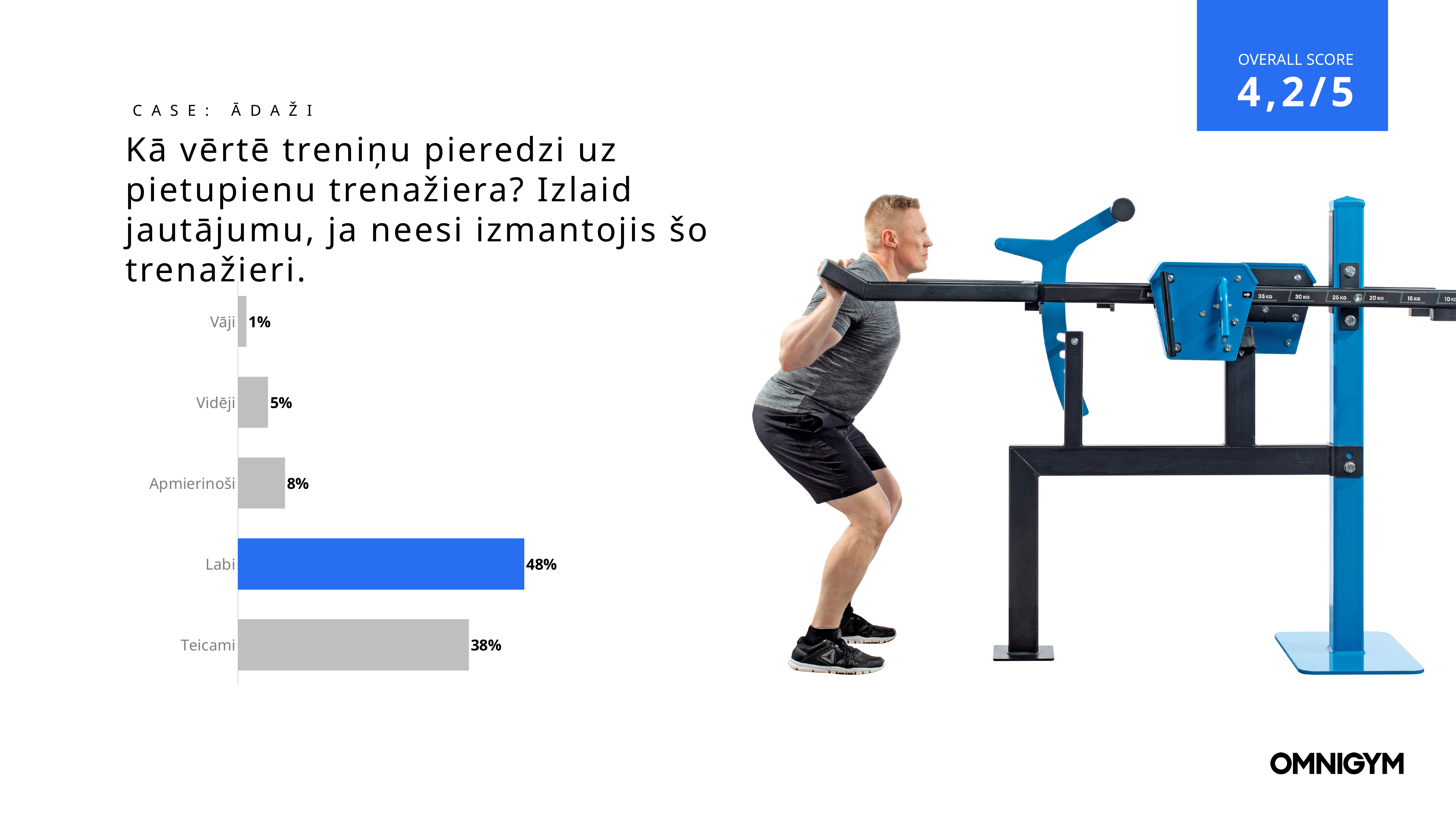
What is the difference between the values for Labi and Teicami? 10% What is the value for Labi? 48% Which category has the highest value? Labi What is the value for Teicami? 38% Which bar is highlighted in blue rather than grey? Labi What is the value for Vāji? 1% What is the value for Apmierinoši? 8% Which is larger, the value for Apmierinoši or the value for Vidēji? Apmierinoši What is the value for Vidēji? 5% Which category has the lowest value? Vāji How many categories are shown in the chart? 5 What kind of chart is shown on the slide? Bar chart